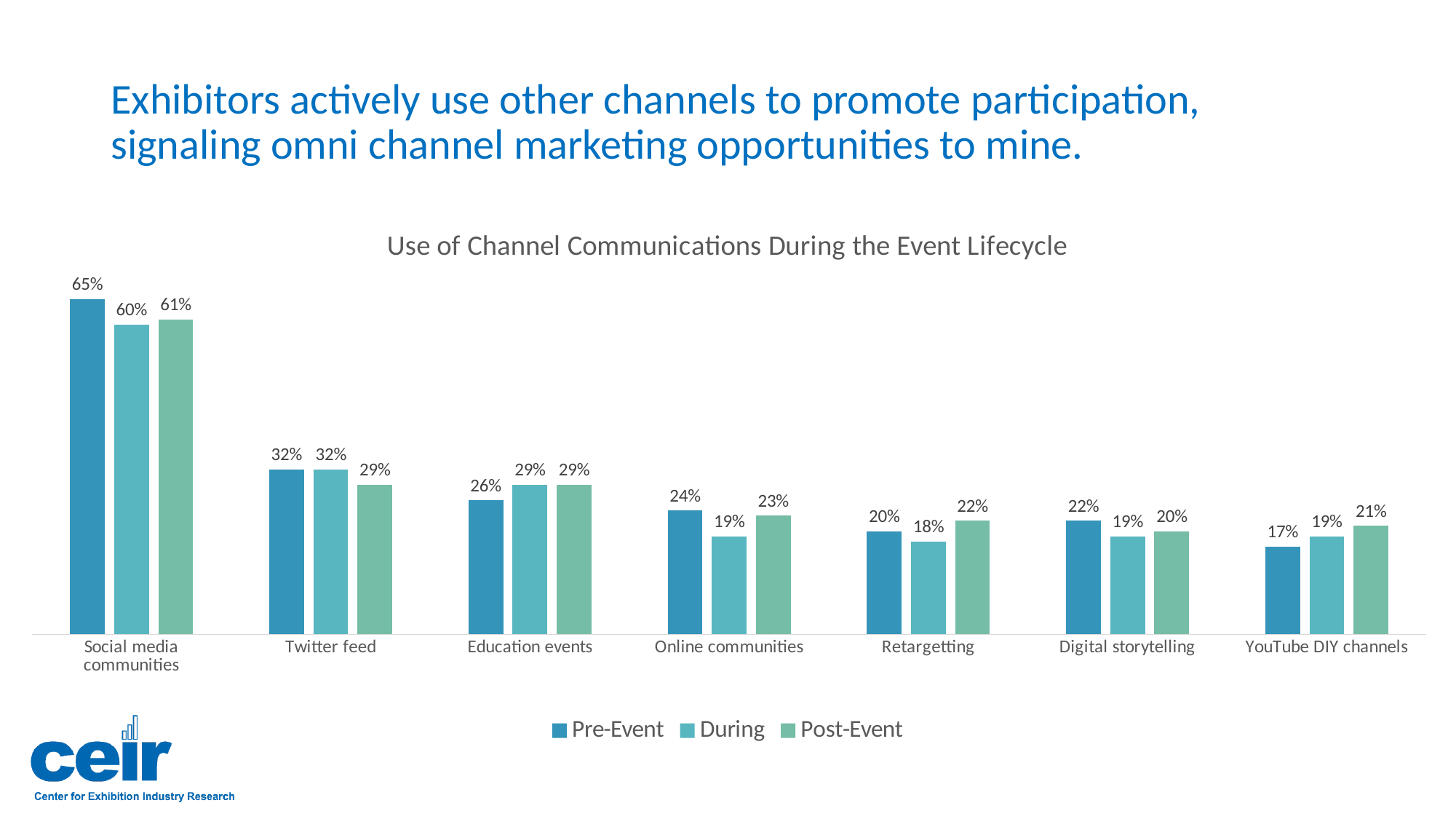
What is the During value for Online communities? 19% How many categories are shown on the x axis? 7 Which category has the lowest Pre-Event value? YouTube DIY channels What kind of chart is shown on the slide? Bar chart What is the Pre-Event value for Social media communities? 65% What is the difference between the During and Post-Event values for Twitter feed? 3% What is the difference between the Pre-Event and During values for Social media communities? 5% What is the Post-Event value for YouTube DIY channels? 21% Which category has the highest Pre-Event value? Social media communities How many series does the legend list? 3 Which is larger for Retargetting: the Pre-Event value or the Post-Event value? Post-Event What is the title of the chart? Use of Channel Communications During the Event Lifecycle